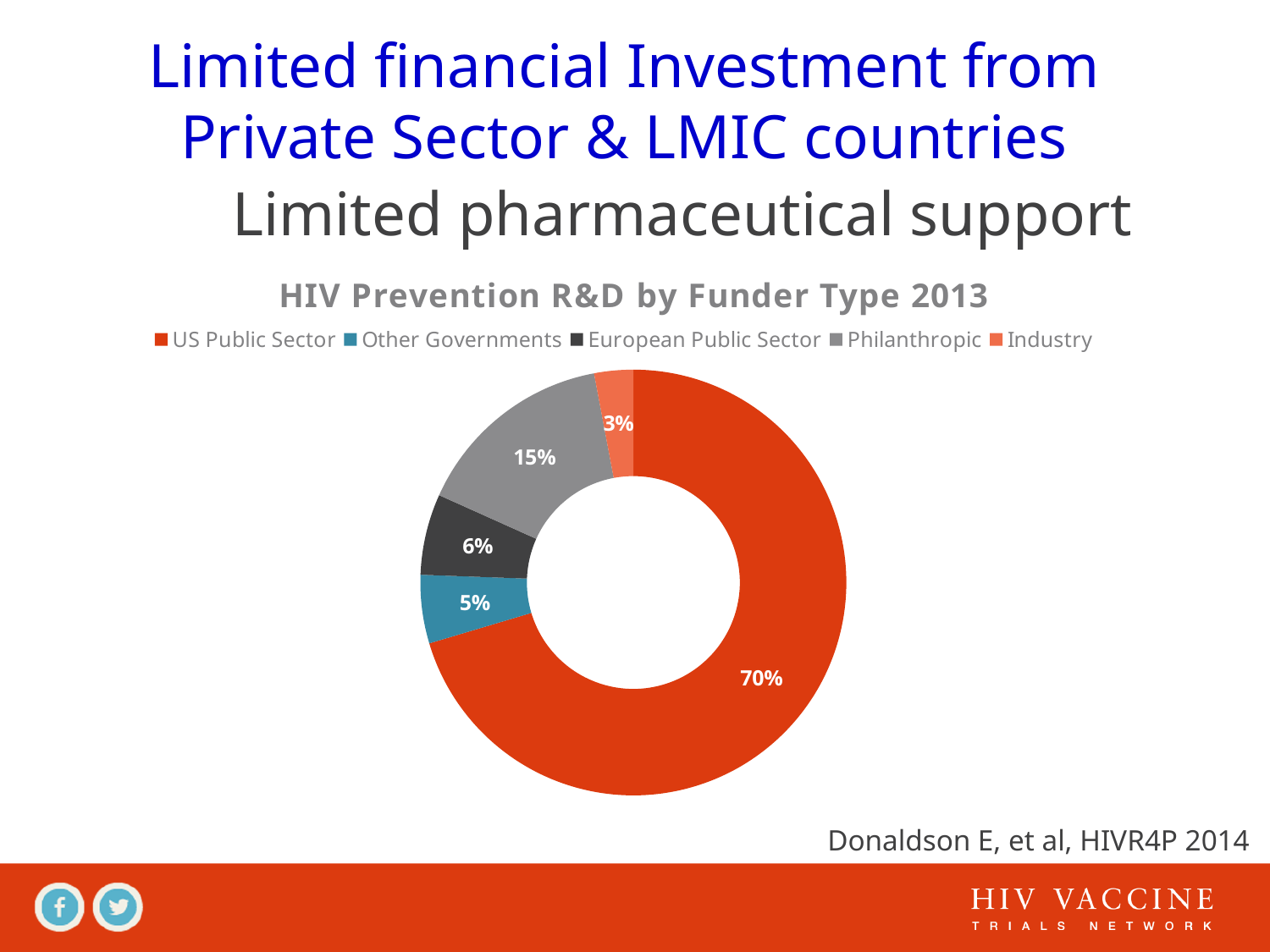
Which funder type has the smallest share in the chart? Industry What share of HIV prevention R&D funding in 2013 came from the US Public Sector? 70% Which is larger, the share for Philanthropic or the share for European Public Sector? Philanthropic How many funder types are shown in the chart? 5 What percentage is shown for the European Public Sector? 6% What percentage is shown for Other Governments? 5% What percentage of the chart is attributed to Philanthropic funders? 15% Which funder type has the largest share in the chart? US Public Sector What share does Industry hold in the HIV Prevention R&D by Funder Type 2013 chart? 3% What kind of chart is used on this slide? Doughnut (pie) chart What is the title of the chart? HIV Prevention R&D by Funder Type 2013 How many percentage points larger is the US Public Sector share than the Philanthropic share? 55